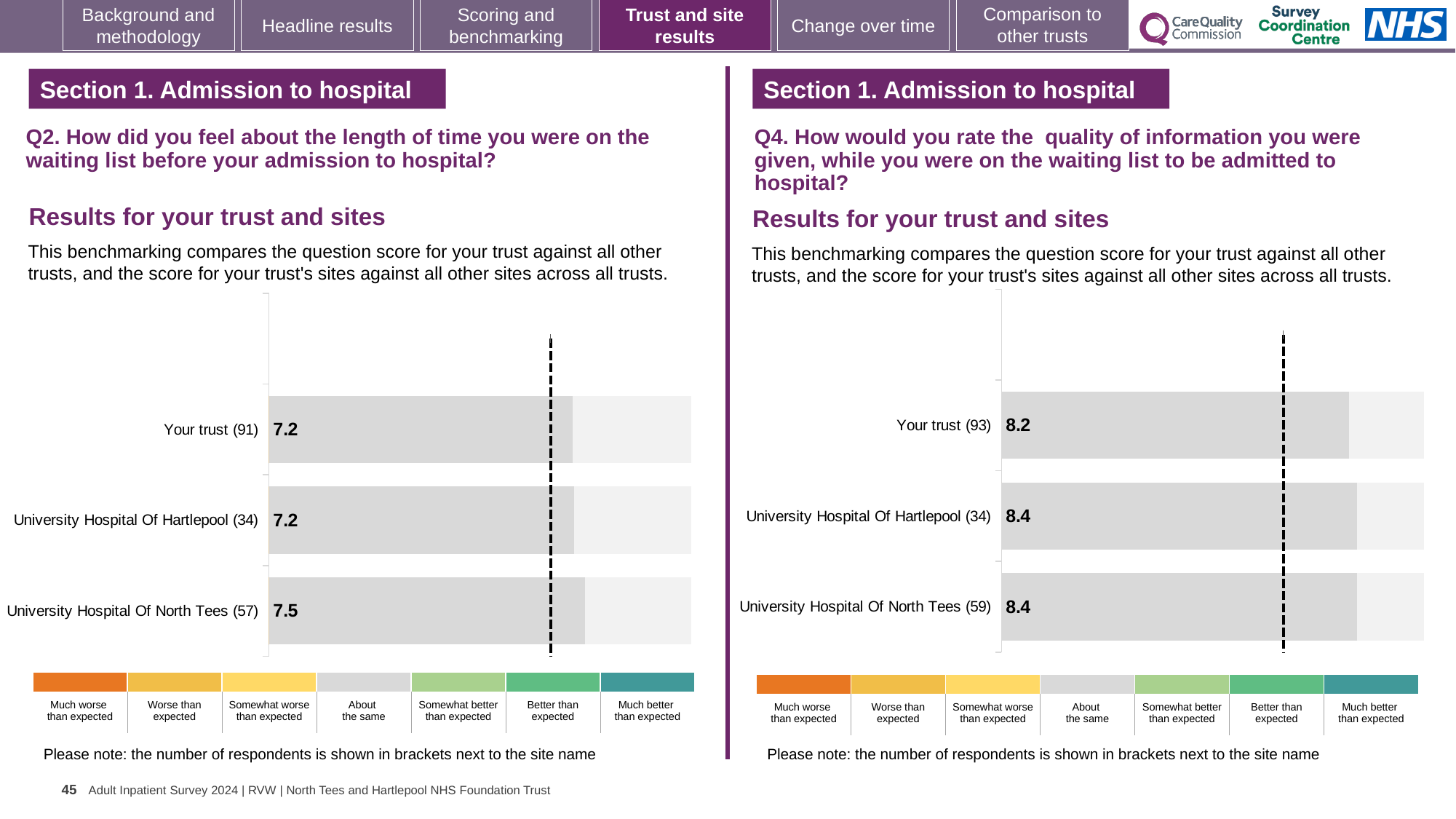
What type of chart is used in the Q2 chart on the left? Bar chart In the Q2 chart on the left, which site or trust has the highest score? University Hospital Of North Tees (57) In the Q4 chart on the right, which is larger: the score for Your trust (93) or University Hospital Of North Tees (59)? University Hospital Of North Tees (59) In the Q2 chart on the left, how many bars are plotted? 3 In the Q4 chart on the right, what is the score for Your trust (93)? 8.2 In the Q2 chart on the left, what is the score for University Hospital Of North Tees (57)? 7.5 In the Q4 chart on the right, what is the difference between the scores for University Hospital Of North Tees (59) and Your trust (93)? 0.2 In the Q2 chart on the left, what is the score for Your trust (91)? 7.2 In the Q4 chart on the right, which has the lowest score? Your trust (93) In the Q2 chart on the left, what is the difference between the scores for University Hospital Of North Tees (57) and University Hospital Of Hartlepool (34)? 0.3 In the Q4 chart on the right, how many respondents are shown in brackets for University Hospital Of North Tees? 59 In the Q4 chart on the right, what is the score for University Hospital Of Hartlepool (34)? 8.4